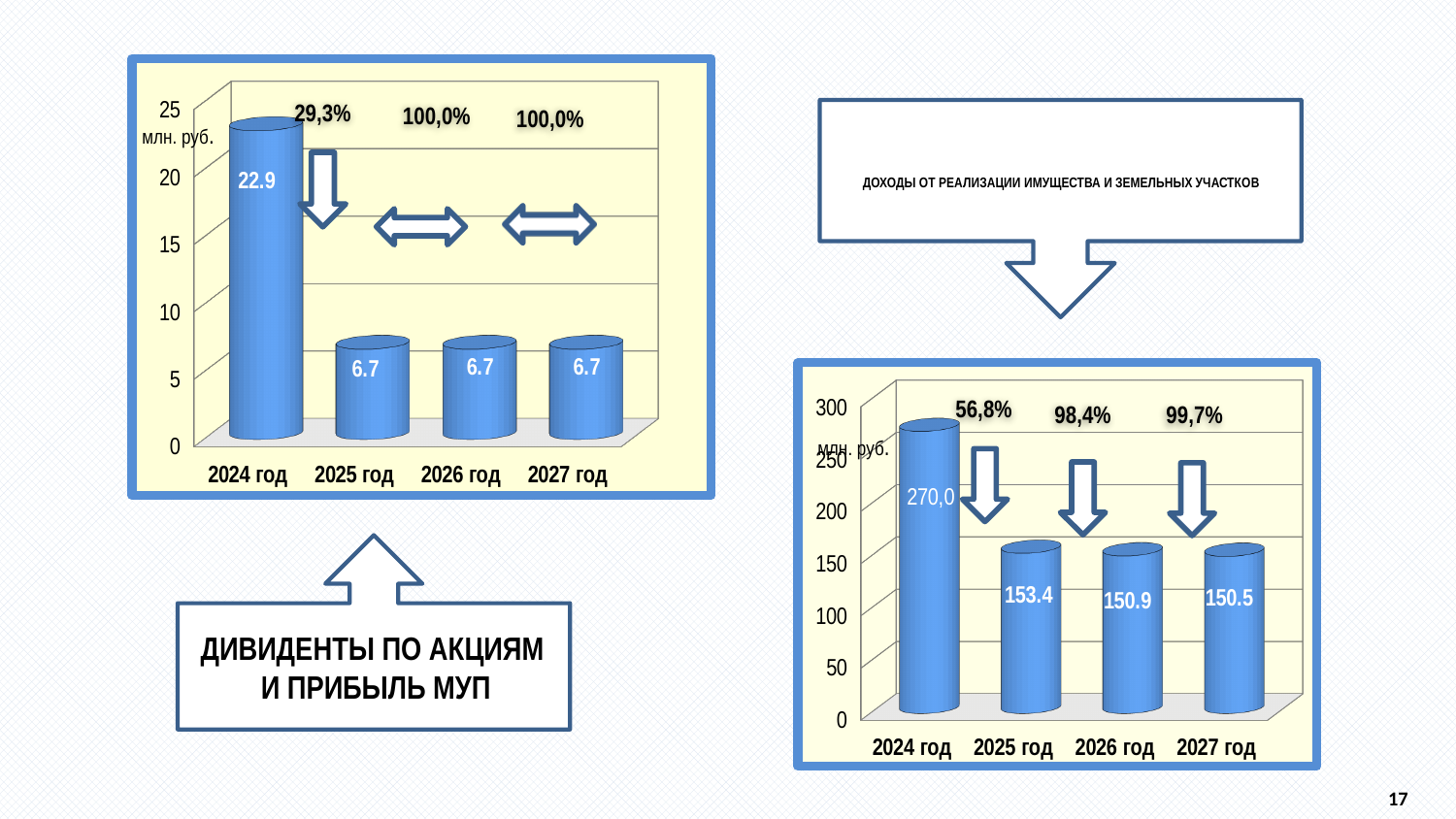
In the left chart (Дивиденты по акциям и прибыль МУП), which year has the highest value? 2024 год What unit is shown on the y axis of the left chart (Дивиденты по акциям и прибыль МУП)? млн. руб. What kind of chart is the right chart (Доходы от реализации имущества и земельных участков)? bar chart In the left chart (Дивиденты по акциям и прибыль МУП), what is the difference between the values for 2024 год and 2025 год? 16.2 In the right chart (Доходы от реализации имущества и земельных участков), what is the value for 2024 год? 270,0 In the left chart (Дивиденты по акциям и прибыль МУП), what is the value for 2026 год? 6.7 In the right chart (Доходы от реализации имущества и земельных участков), is the value for 2024 год larger or smaller than the value for 2025 год? larger In the left chart (Дивиденты по акциям и прибыль МУП), how many years are shown on the x axis? 4 In the right chart (Доходы от реализации имущества и земельных участков), what is the value for 2027 год? 150.5 In the right chart (Доходы от реализации имущества и земельных участков), what is the difference between the values for 2025 год and 2026 год? 2.5 In the left chart (Дивиденты по акциям и прибыль МУП), what is the value for 2024 год? 22.9 In the right chart (Доходы от реализации имущества и земельных участков), which year has the lowest value? 2027 год